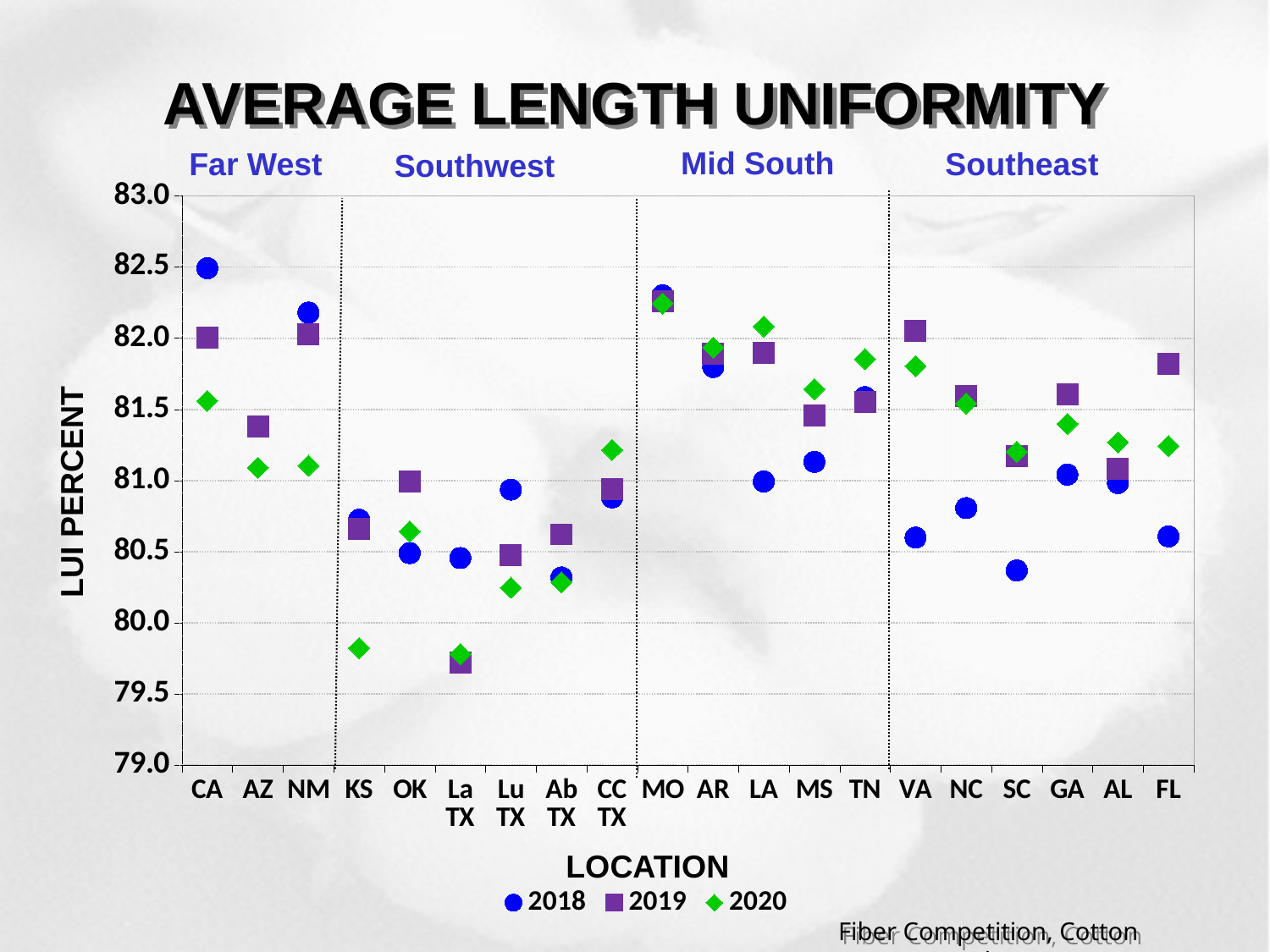
How many series does the legend list? 3 Is the 2018 value for SC greater or less than 80.5? less Which is larger for VA: the 2018 value or the 2019 value? 2019 What kind of chart is shown on the slide? Scatter (dot) chart How many locations are plotted along the x axis? 20 Which location has the lowest 2019 value? La TX Which location has the highest 2018 value? CA Which is larger: the 2020 value for MO or the 2020 value for KS? MO Is the 2020 value for KS greater or less than 80.0? less What is the title of the y axis? LUI PERCENT Is the 2019 value for La TX greater or less than 80.0? less